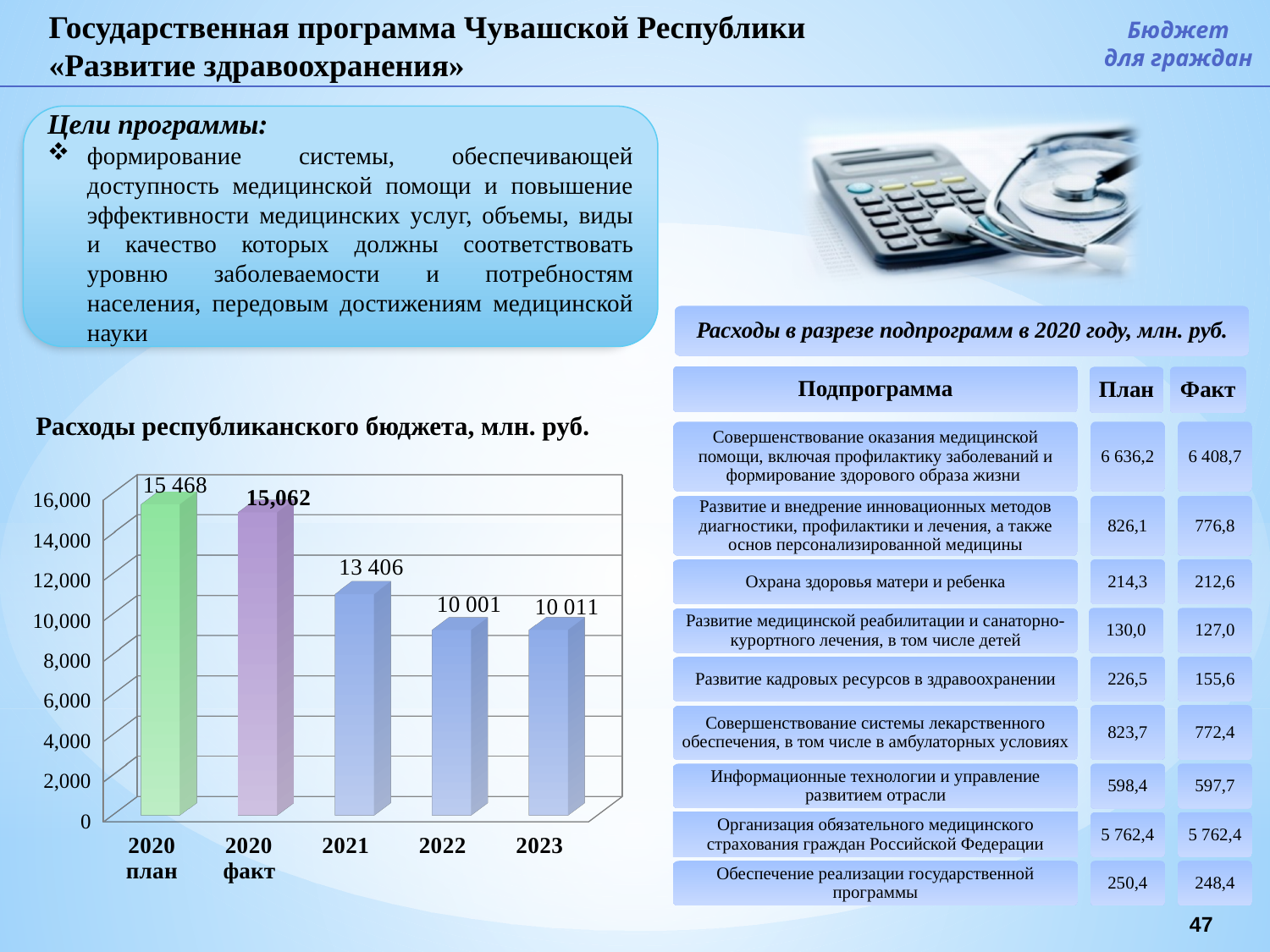
Which category has the lowest value in the chart? 2022 What is the difference between the 2020 план and 2020 факт values? 406 What is the value for 2020 факт in the chart? 15,062 What is the value for 2023 in the chart? 10 011 What is the value for 2022 in the chart? 10 001 How many bars are shown in the chart? 5 Which is larger, the value for 2021 or the value for 2022? 2021 Which category has the highest value in the chart? 2020 план What kind of chart is 'Расходы республиканского бюджета, млн. руб.'? bar chart What is the value for 2020 план in the chart 'Расходы республиканского бюджета, млн. руб.'? 15 468 What is the value for 2021 in the chart? 13 406